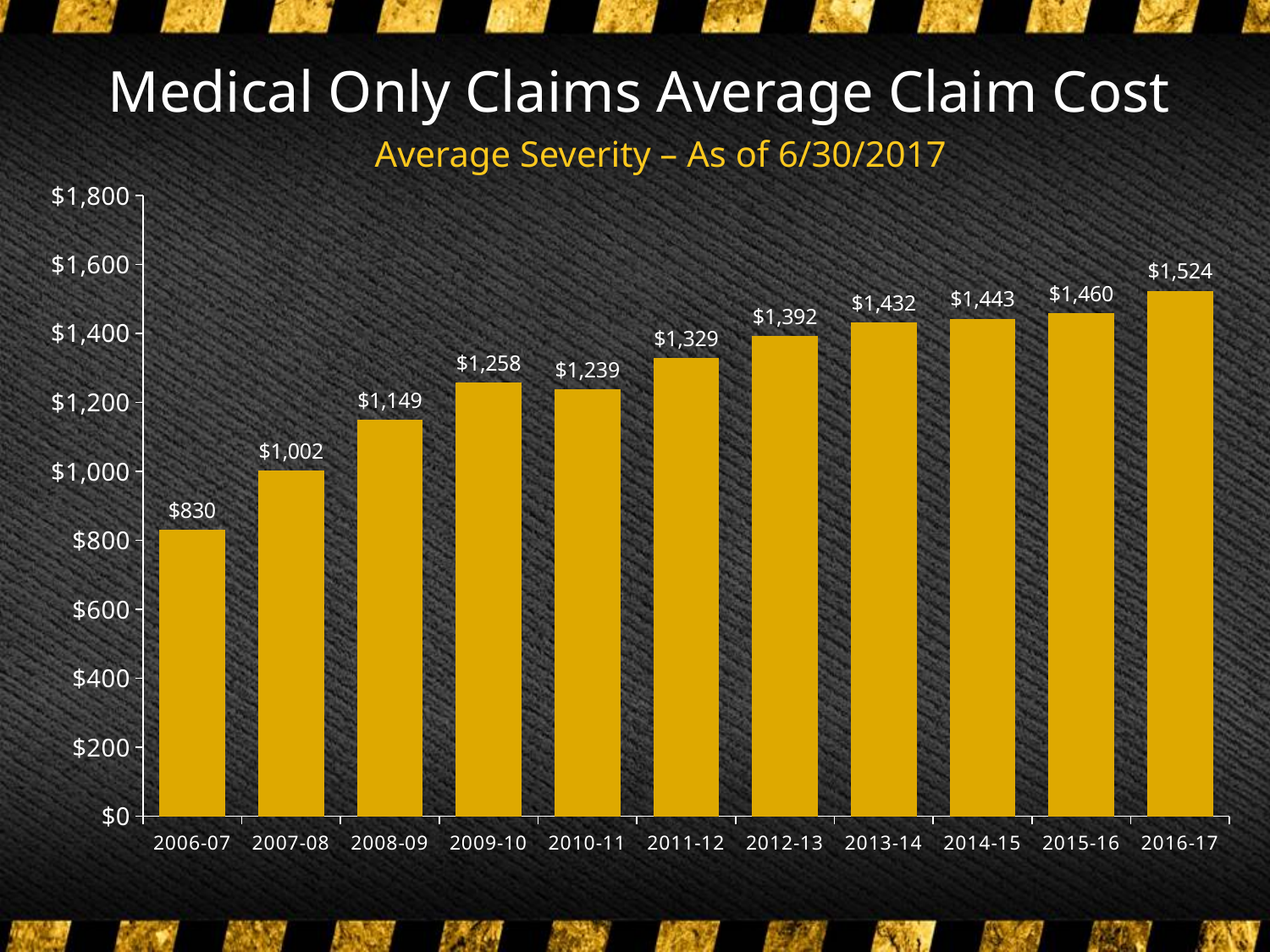
What is the average claim cost for 2016-17? $1,524 Is the value for 2008-09 greater or less than $1,200? less What kind of chart is shown on the slide? bar chart What is the subtitle of the chart? Average Severity – As of 6/30/2017 How many years are shown on the chart? 11 What is the average claim cost for 2006-07? $830 Which is larger, the average claim cost for 2009-10 or 2010-11? 2009-10 What is the difference between the average claim cost in 2016-17 and 2006-07? $694 What is the difference between the average claim cost in 2009-10 and 2010-11? $19 What is the average claim cost for 2012-13? $1,392 Which year has the highest average claim cost? 2016-17 Which year has the lowest average claim cost? 2006-07